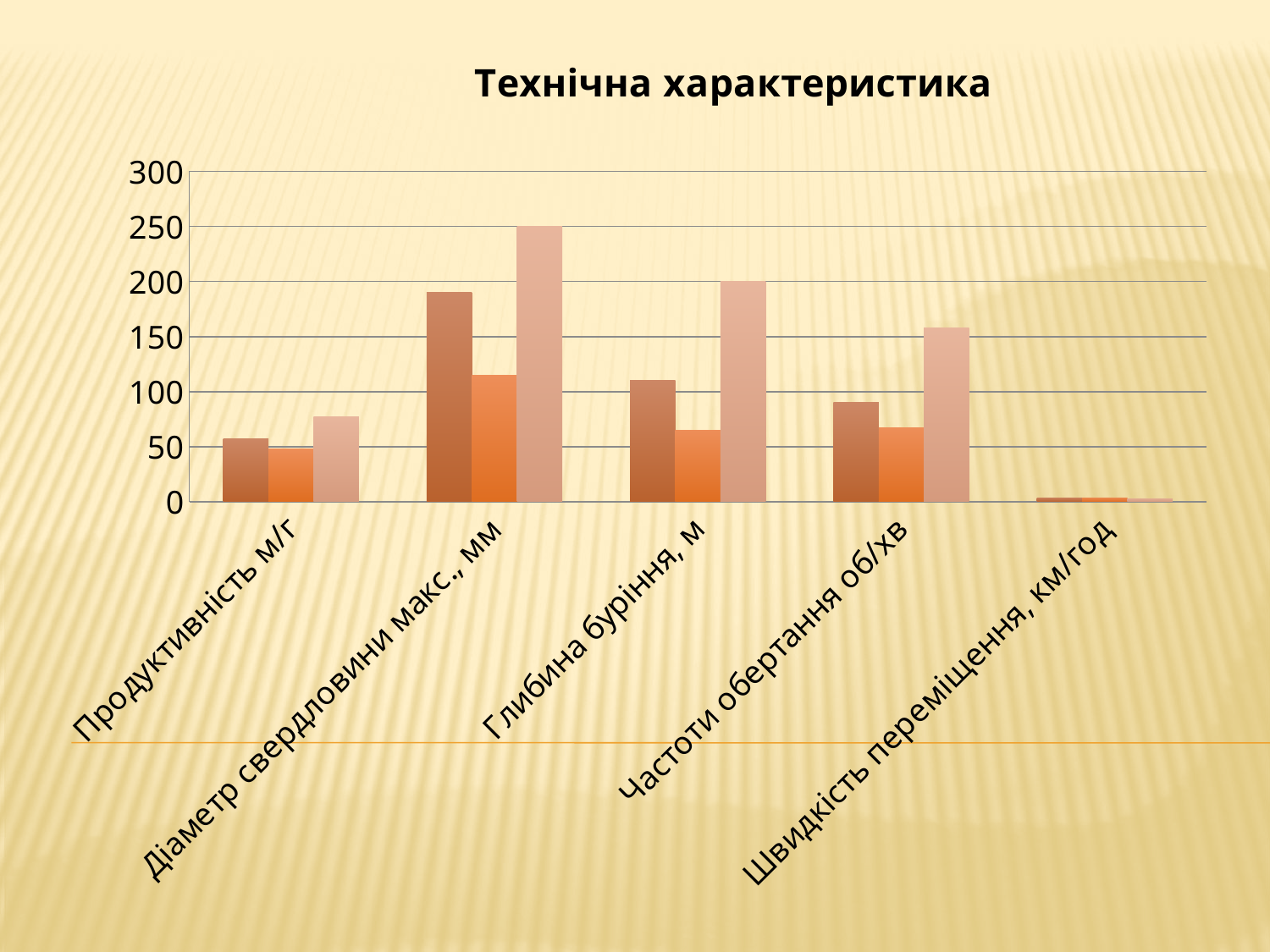
Is the value of the first (leftmost) bar for Діаметр свердловини макс., мм greater or less than 150? greater How many categories are shown on the x axis of the chart? 5 What is the title of the chart? Технічна характеристика What is the value of the tallest (rightmost) bar for Діаметр свердловини макс., мм? 250 Which is larger: the rightmost bar for Діаметр свердловини макс., мм or the rightmost bar for Глибина буріння, м? Діаметр свердловини макс., мм Which category has the tallest bar in the chart? Діаметр свердловини макс., мм Is the value of the middle bar for Глибина буріння, м greater or less than 100? less What kind of chart is shown on the slide? bar chart Which category has the lowest bars in the chart? Швидкість переміщення, км/год How many bars are plotted for each category in the chart? 3 Is the value of the rightmost bar for Частоти обертання об/хв greater or less than 150? greater What is the value of the tallest (rightmost) bar for Глибина буріння, м? 200